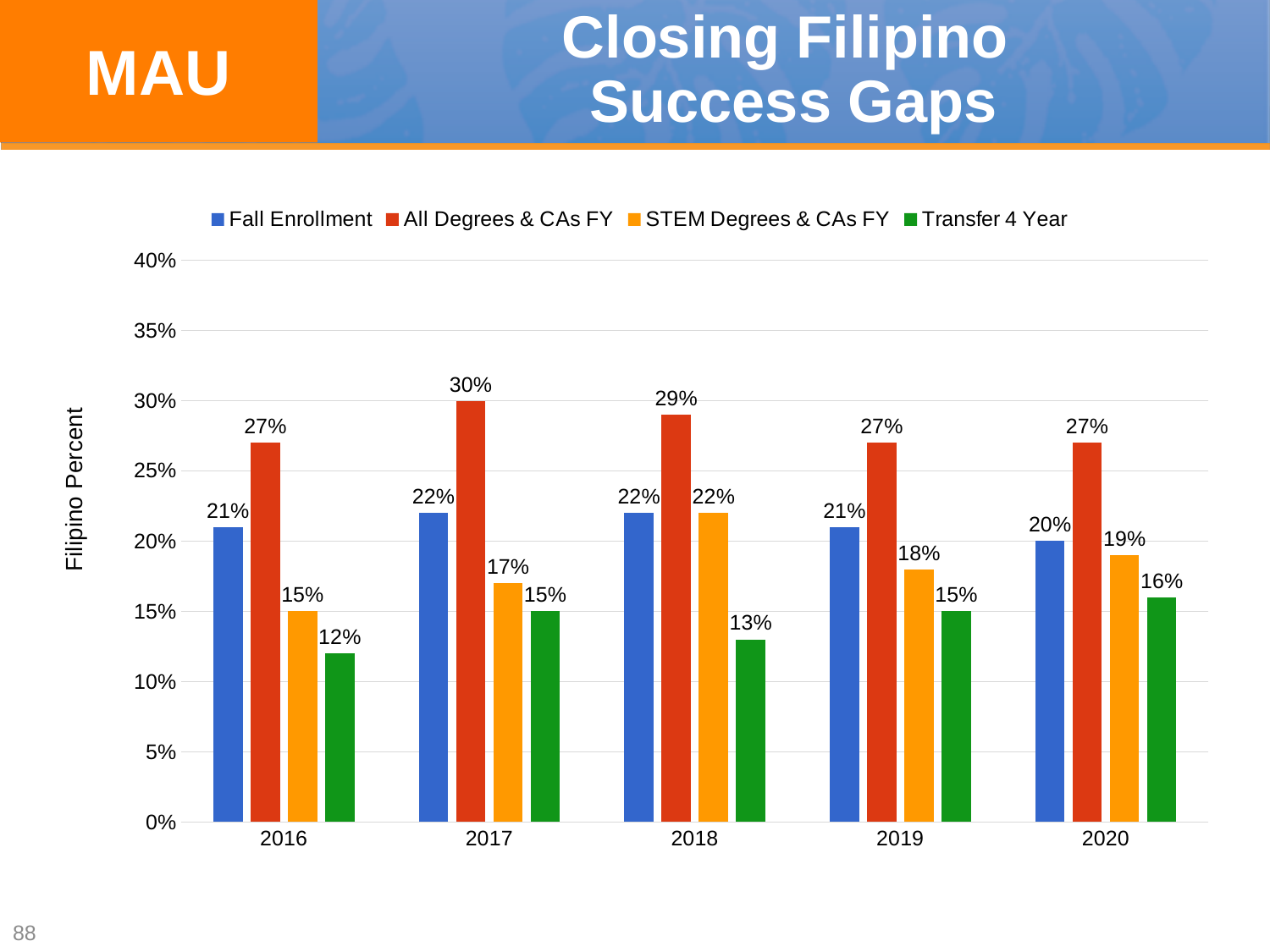
What is the difference between the All Degrees & CAs FY value and the Fall Enrollment value in 2017? 8% How many series does the legend list? 4 What kind of chart is shown on the slide? Bar chart What is the label on the vertical axis? Filipino Percent In which year is the All Degrees & CAs FY value highest? 2017 What is the All Degrees & CAs FY value for 2018? 29% What is the Fall Enrollment value for 2017? 22% What is the Transfer 4 Year value for 2016? 12% What is the STEM Degrees & CAs FY value for 2020? 19% How many years are shown on the x axis? 5 In which year is the Transfer 4 Year value lowest? 2016 Which is larger in 2019: the STEM Degrees & CAs FY value or the Transfer 4 Year value? STEM Degrees & CAs FY